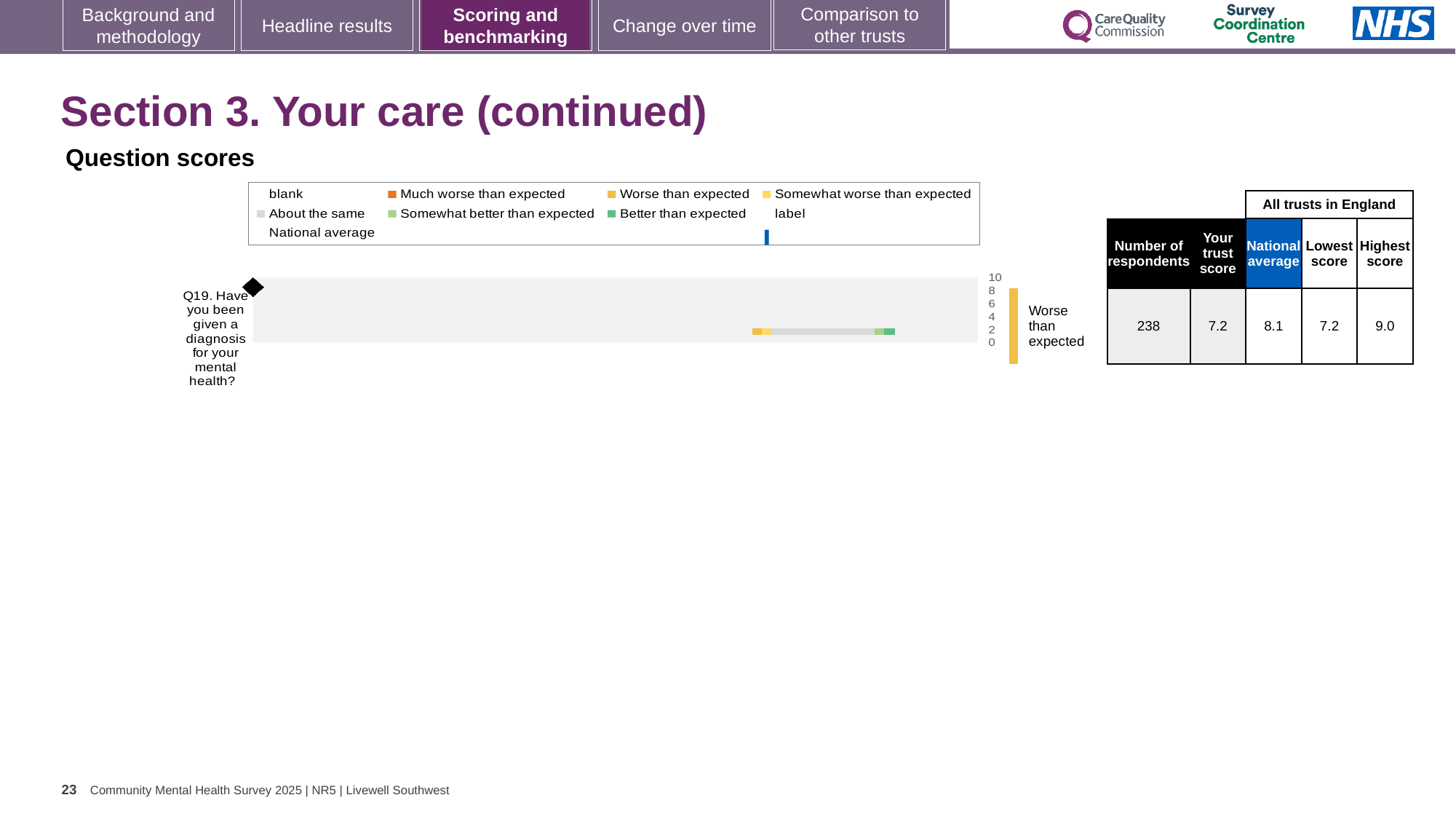
What rating label is shown to the right of the chart for Q19? Worse than expected What is the highest score among all trusts in England for Q19? 9.0 What is the difference between the national average and the trust score for Q19? 0.9 What is the difference between the highest and lowest scores among all trusts in England for Q19? 1.8 What is the number of respondents for Q19 shown in the table next to the chart? 238 How many questions are plotted in the chart on this slide? 1 What is the maximum value shown on the chart's vertical axis scale? 10 Which is larger for Q19, the trust score or the national average? National average What is the lowest score among all trusts in England for Q19? 7.2 What is the national average for Q19 shown in the table next to the chart? 8.1 What is the trust score for Q19 shown in the table next to the chart? 7.2 Which question is shown in the chart on this slide? Q19. Have you been given a diagnosis for your mental health?